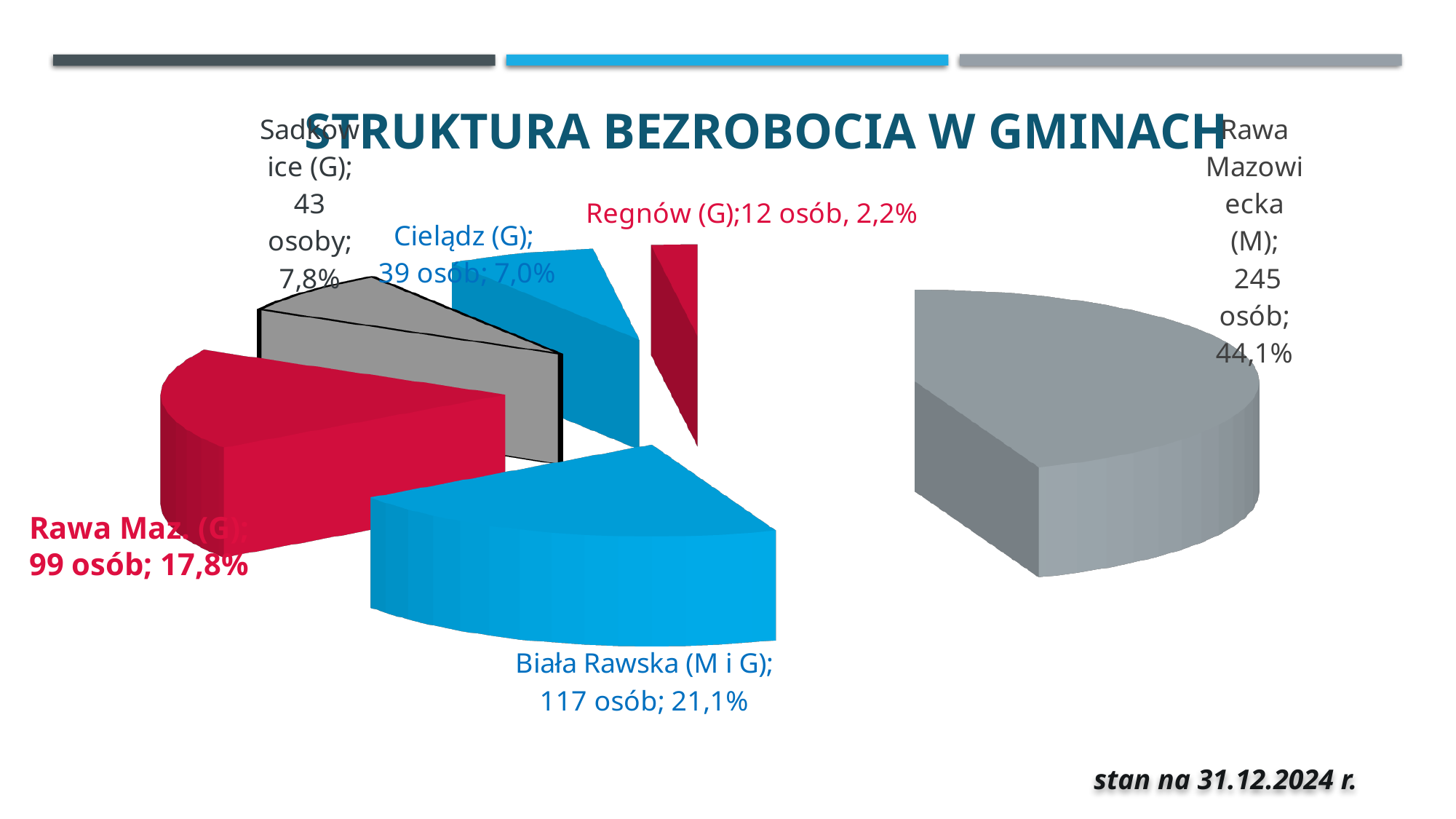
Which has more unemployed persons, Sadkowice (G) or Cielądz (G)? Sadkowice (G) How many unemployed persons are shown for Rawa Mazowiecka (M)? 245 osób What percentage share is shown for Cielądz (G)? 7,0% What is the difference in the number of persons between Biała Rawska (M i G) and Rawa Maz. (G)? 18 Which municipality has the smallest slice of the pie chart? Regnów (G) What percentage share does Biała Rawska (M i G) have in the pie chart? 21,1% What kind of chart is shown on the slide? Pie chart What date is the data stated as of, according to the note on the slide? 31.12.2024 r. How many slices does the pie chart have? 6 What is the title of the chart? STRUKTURA BEZROBOCIA W GMINACH Which municipality has the largest slice of the pie chart? Rawa Mazowiecka (M) What value is shown for Rawa Maz. (G)? 99 osób